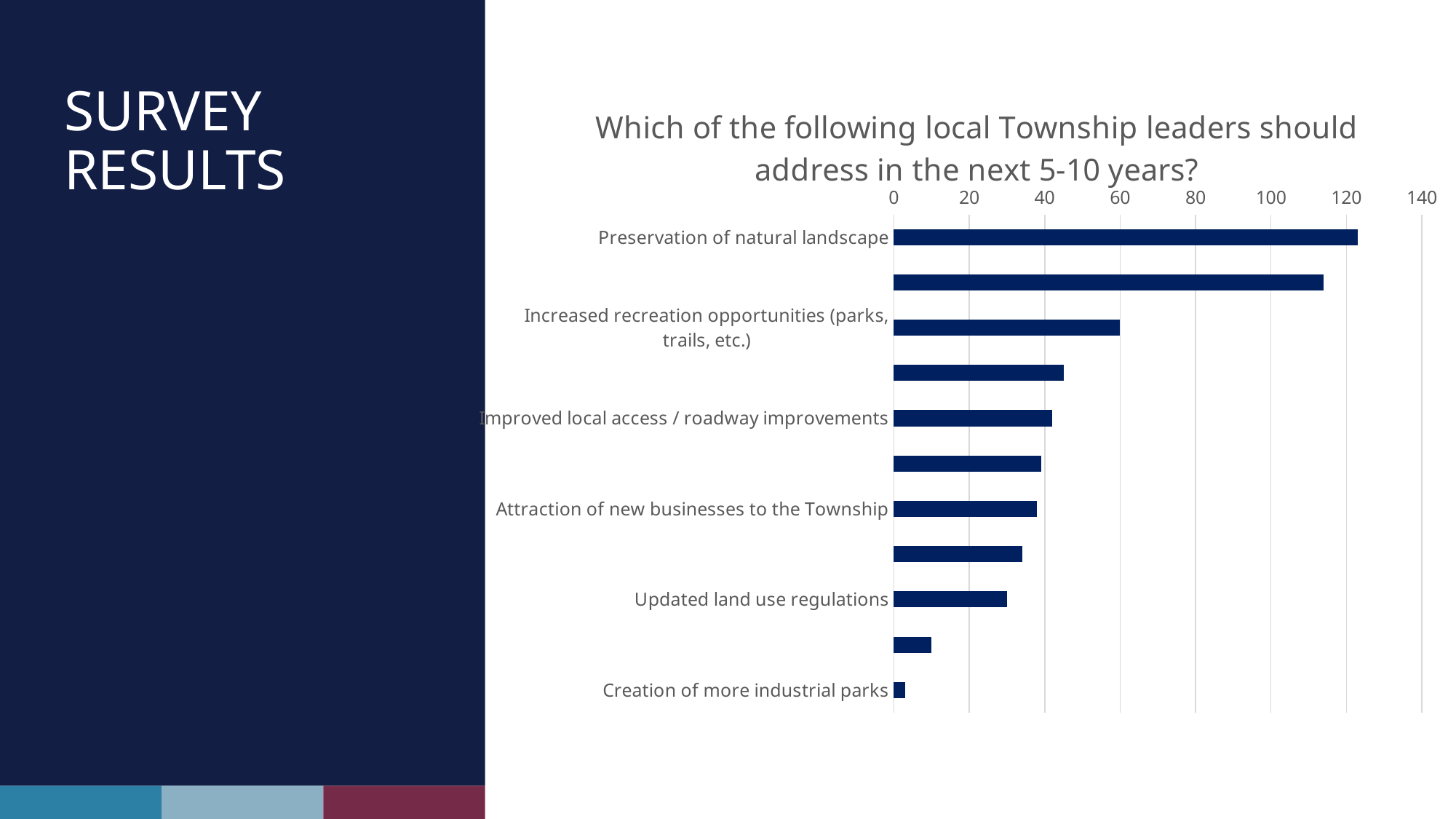
Is the value for Improved local access / roadway improvements greater or less than 60? less How many bars are plotted in the chart? 11 What kind of chart is shown on the slide? Bar chart Which is larger: the value for Preservation of natural landscape or the value for Increased recreation opportunities (parks, trails, etc.)? Preservation of natural landscape Which is larger: the value for Updated land use regulations or the value for Attraction of new businesses to the Township? Attraction of new businesses to the Township Is the value for Updated land use regulations greater or less than 20? greater Which category has the lowest value? Creation of more industrial parks What is the title of the chart? Which of the following local Township leaders should address in the next 5-10 years? Which category has the highest value? Preservation of natural landscape Is the value for Creation of more industrial parks greater or less than 20? less